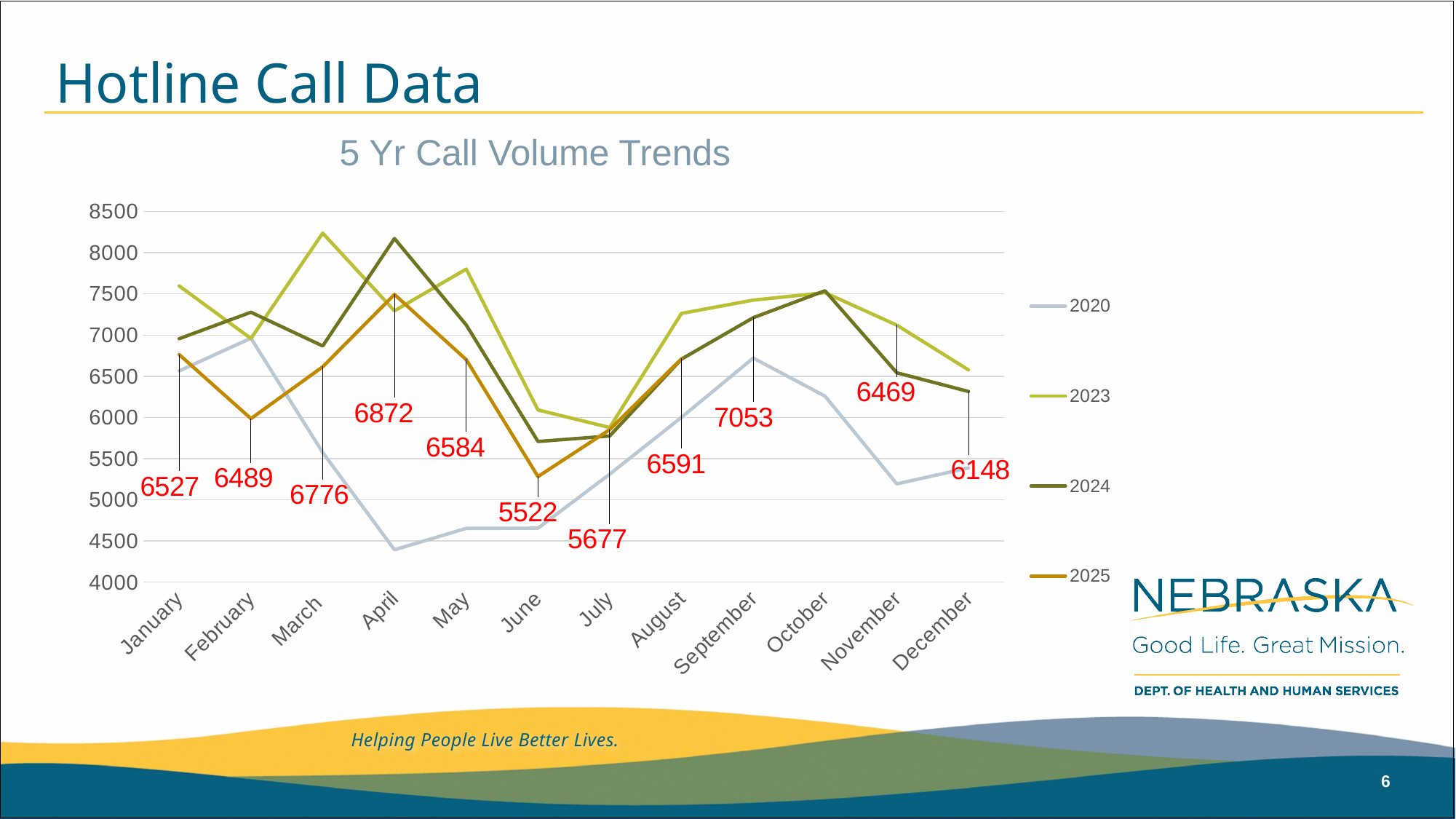
How many months are shown along the x axis? 12 What is the title of the chart? 5 Yr Call Volume Trends Is the value for the 2020 series in November greater or less than 5500? less What is the difference between the red data label values for September and June? 1531 What red data label value is shown for December? 6148 What kind of chart is shown on the slide? line chart What red data label value is shown for September? 7053 How many series does the legend list? 4 Is the value for the 2023 series in March greater or less than 8000? greater Which month has the highest red data label value? September Which month has the lowest red data label value? June What red data label value is shown for June? 5522